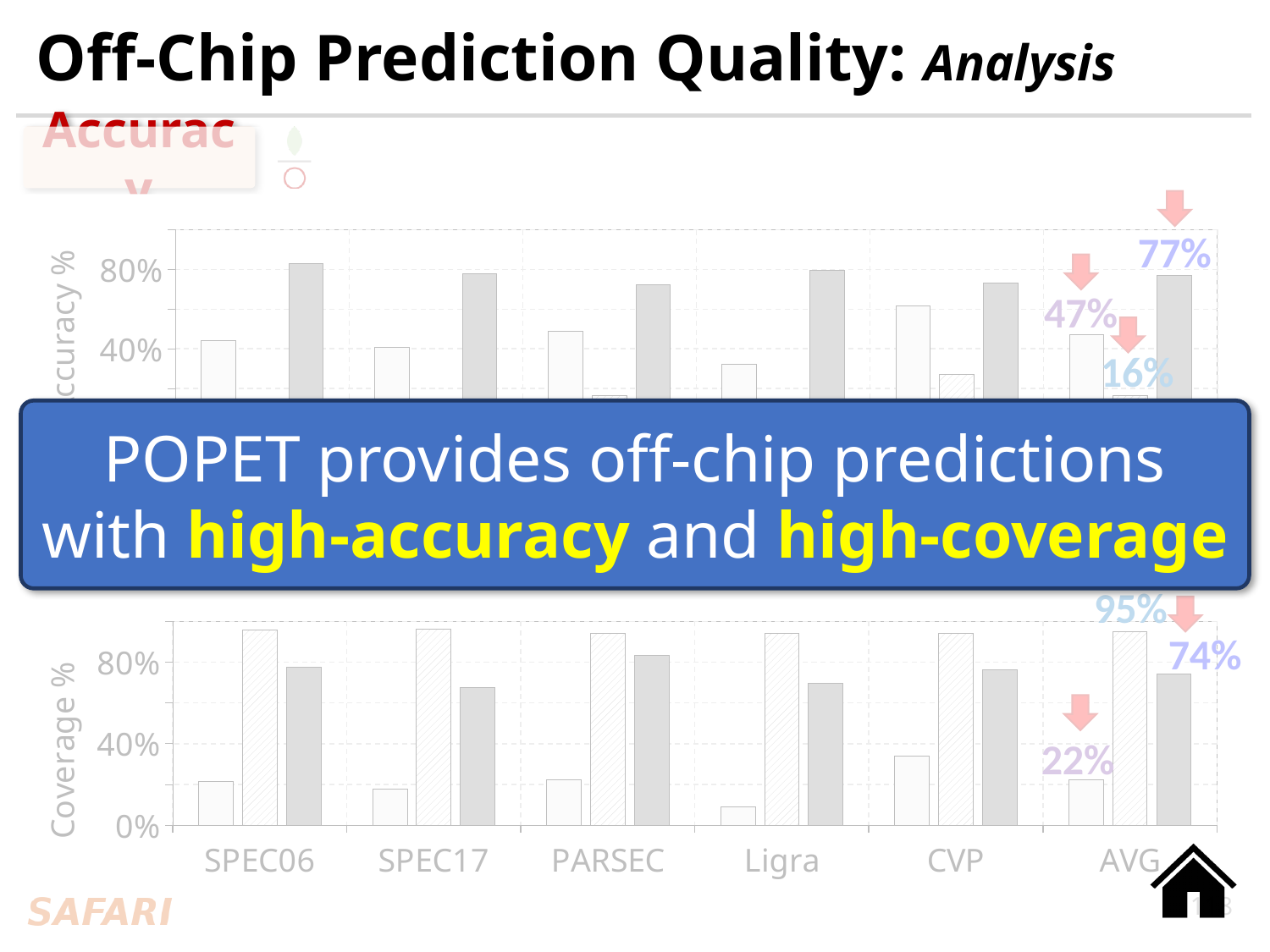
On the Coverage % chart, what is the difference between the 95% and 22% labelled values in the AVG group? 73 percentage points On the Accuracy % chart, what is the labelled value of the shortest bar in the AVG group? 16% On the Accuracy % chart, what is the labelled value of the tallest bar in the AVG group? 77% What kind of chart is the Coverage % chart? bar chart On the Accuracy % chart, what is the difference between the 77% and 47% labelled values in the AVG group? 30 percentage points On the Coverage % chart, what is the labelled value of the hatched bar in the AVG group? 95% How many benchmark categories are shown along the x axis of the Coverage % chart? 6 On the Coverage % chart, what is the labelled value of the last (rightmost) bar in the AVG group? 74% On the Coverage % chart, what is the labelled value of the first (leftmost) bar in the AVG group? 22% On the Coverage % chart, which labelled AVG value is larger, 95% or 74%? 95% On the Coverage % chart, is the value of the first bar for Ligra greater or less than 40%? less On the Accuracy % chart, what is the labelled value of the first (leftmost) bar in the AVG group? 47%